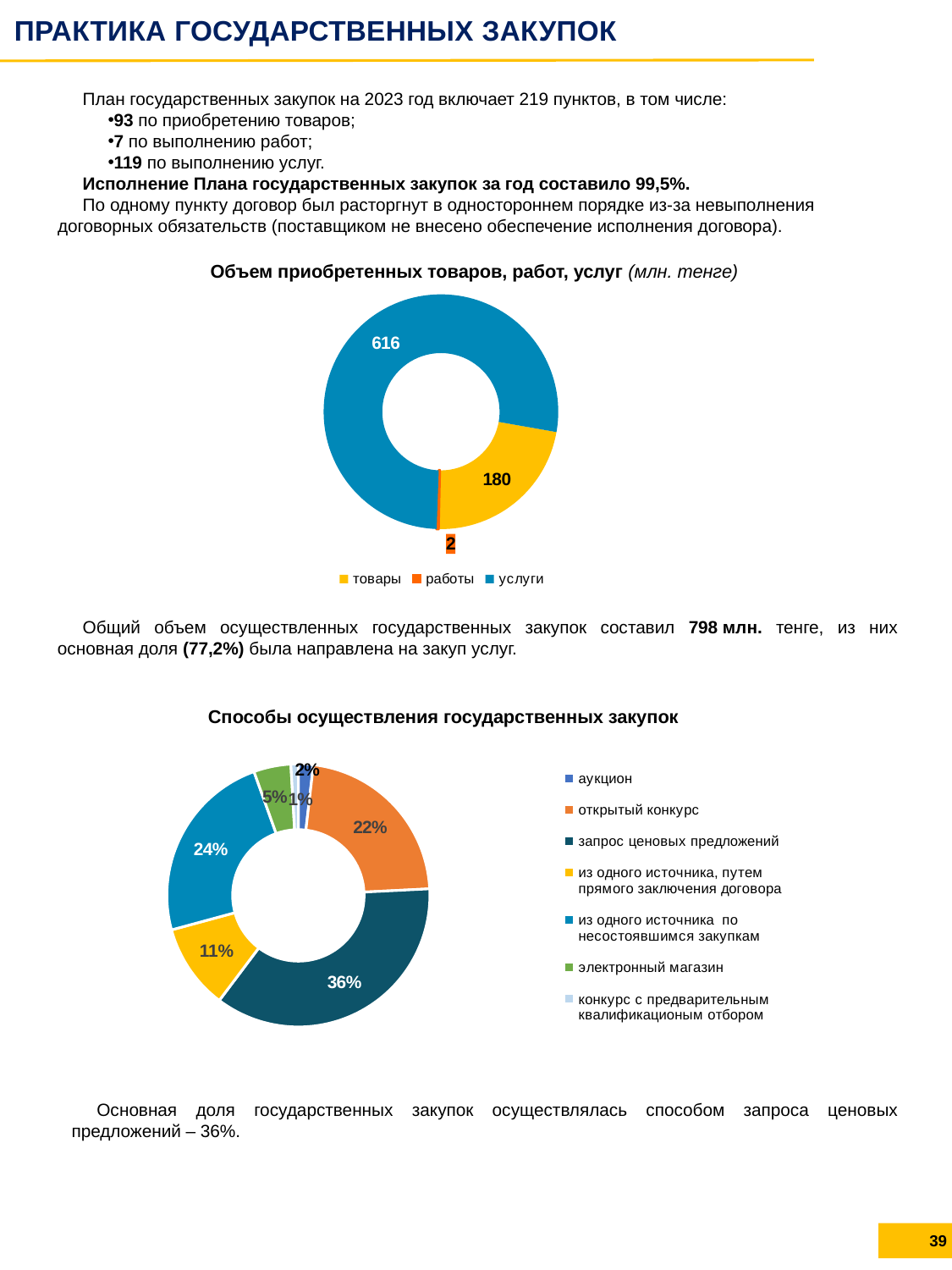
What type of chart is 'Способы осуществления государственных закупок'? pie (donut) chart How many entries does the legend of the chart 'Объем приобретенных товаров, работ, услуг' list? 3 In the chart 'Способы осуществления государственных закупок', what is the share for запрос ценовых предложений? 36% In the chart 'Объем приобретенных товаров, работ, услуг', what is the value for товары? 180 In the chart 'Объем приобретенных товаров, работ, услуг', what is the value for услуги? 616 In the chart 'Способы осуществления государственных закупок', what is the share for открытый конкурс? 22% In the chart 'Объем приобретенных товаров, работ, услуг', what is the total of all three categories? 798 In the chart 'Объем приобретенных товаров, работ, услуг', which category has the largest value? услуги In the chart 'Способы осуществления государственных закупок', what is the share for электронный магазин? 5% In the chart 'Объем приобретенных товаров, работ, услуг', what is the value for работы? 2 In the chart 'Способы осуществления государственных закупок', which method has the largest share? запрос ценовых предложений In the chart 'Объем приобретенных товаров, работ, услуг', what is the difference between услуги and товары? 436